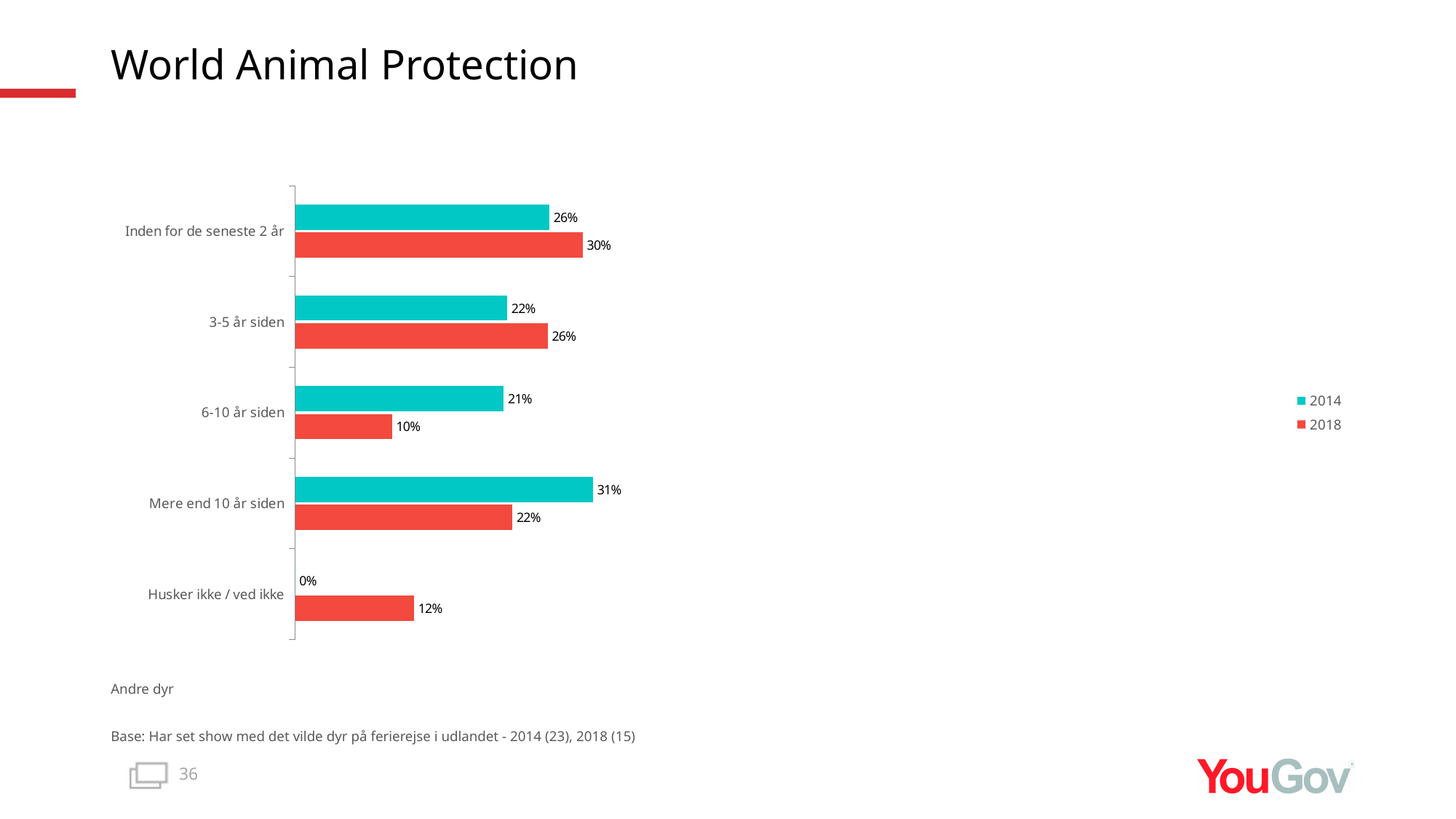
What is the 2018 value for "Inden for de seneste 2 år"? 30% What is the 2014 value for "6-10 år siden"? 21% What is the 2018 value for "Husker ikke / ved ikke"? 12% Which category has the lowest 2018 value? 6-10 år siden How many categories are shown on the chart? 5 What is the 2014 value for "Husker ikke / ved ikke"? 0% What is the difference between the 2014 and 2018 values for "Mere end 10 år siden"? 9% How many series does the legend list? 2 Which category has the highest 2014 value? Mere end 10 år siden Which is larger for "3-5 år siden": the 2014 value or the 2018 value? 2018 What kind of chart is shown on the slide? Bar chart Which colour represents the 2018 series? Red